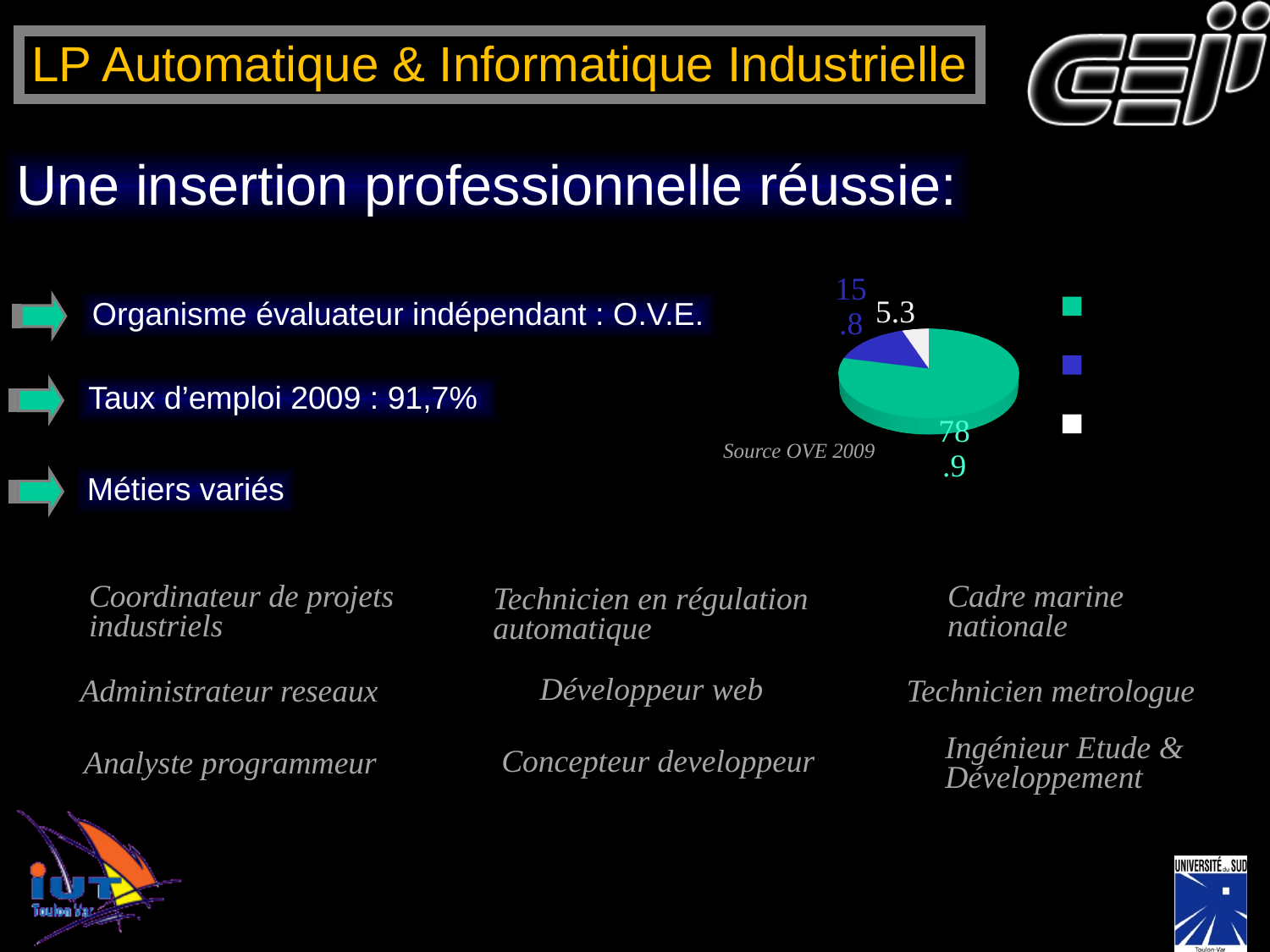
How many entries does the pie chart's legend list? 3 What source is cited below the pie chart? Source OVE 2009 Which is larger in the pie chart, the blue slice or the white slice? blue slice What is the difference between the green slice value and the blue slice value in the pie chart? 63.1 Which colour slice of the pie chart is the largest? green What value is labelled on the green slice of the pie chart? 78.9 What kind of chart is shown on the slide? pie chart What value is labelled on the blue slice of the pie chart? 15.8 How many slices does the pie chart have? 3 What value is labelled on the white slice of the pie chart? 5.3 Which colour slice of the pie chart is the smallest? white What is the total of the three values labelled on the pie chart? 100